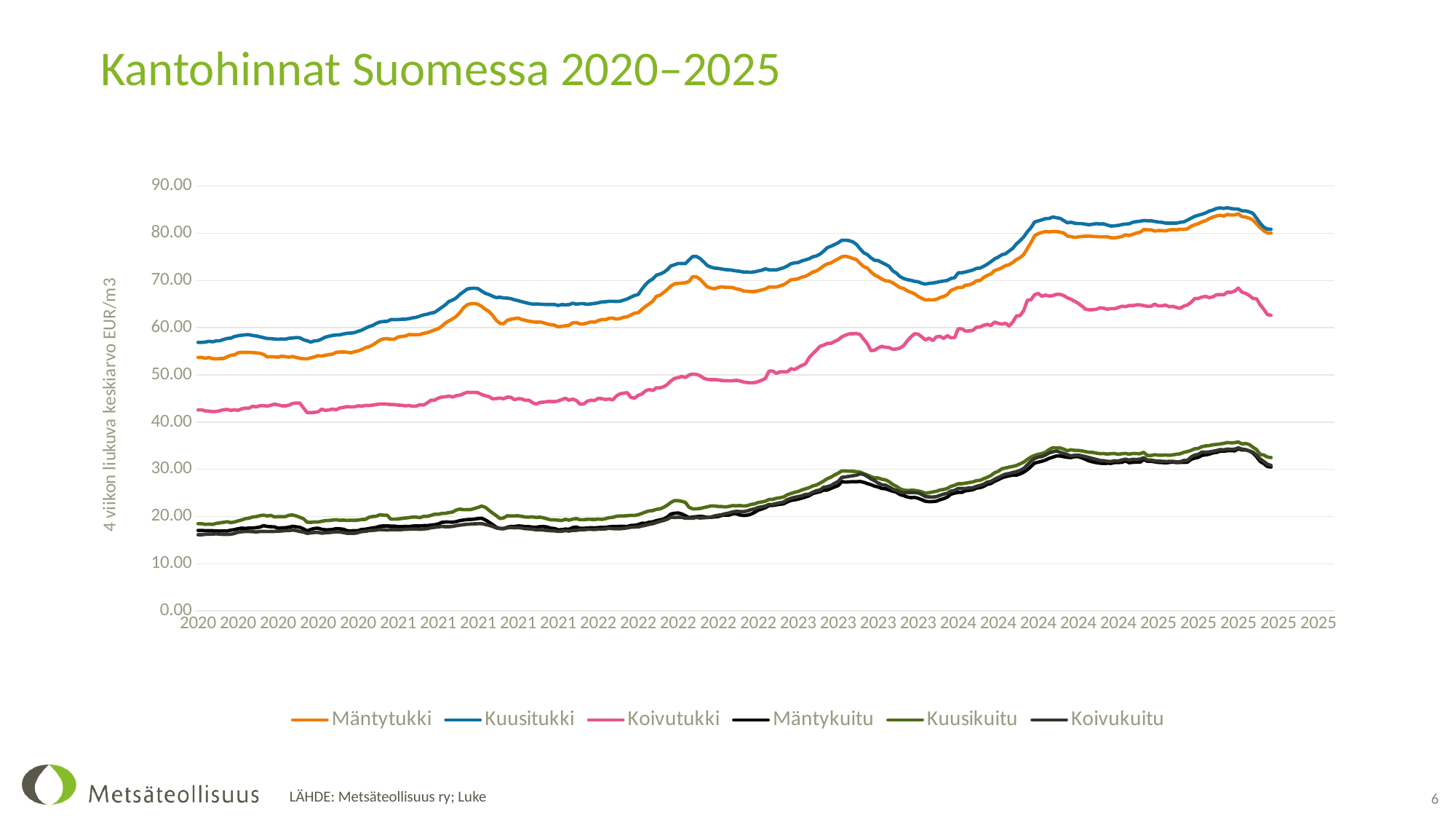
Does the Kuusitukki series rise or fall overall from 2020 to 2025? rise How many series does the legend list? 6 Which of the three tukki series (Mäntytukki, Kuusitukki, Koivutukki) has the lowest values? Koivutukki Is the value for Kuusitukki at the start of 2020 greater or less than 50? greater What is the title of the chart? Kantohinnat Suomessa 2020–2025 Is the value for Mäntykuitu at the start of 2020 greater or less than 20? less Which series has the highest values across the whole period? Kuusitukki Which is higher throughout the period, Kuusitukki or Mäntytukki? Kuusitukki What is the label of the vertical axis? 4 viikon liukuva keskiarvo EUR/m3 Is the peak value for Kuusitukki in 2025 greater or less than 80? greater Which is higher throughout the period, Koivutukki or Kuusikuitu? Koivutukki What kind of chart is shown on the slide? line chart